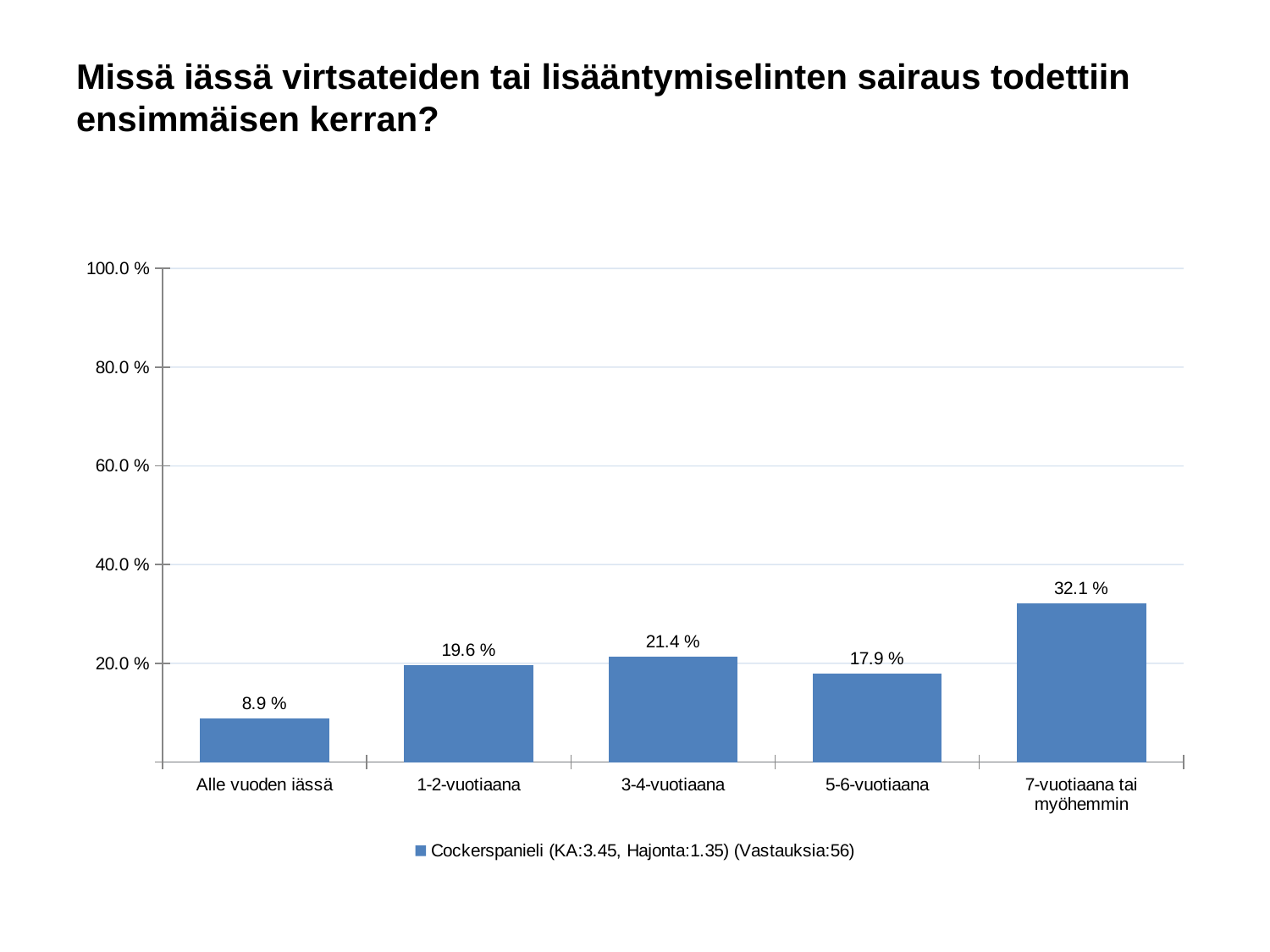
Which category has the highest value? 7-vuotiaana tai myöhemmin Which category has the lowest value? Alle vuoden iässä Which is larger, the value for "1-2-vuotiaana" or the value for "5-6-vuotiaana"? 1-2-vuotiaana What is the value for "3-4-vuotiaana"? 21.4 % What is the value for "Alle vuoden iässä"? 8.9 % What kind of chart is shown on the slide? bar chart How many categories are shown on the x axis? 5 What is the difference between the values for "7-vuotiaana tai myöhemmin" and "Alle vuoden iässä"? 23.2 % What is the legend entry for the series? Cockerspanieli (KA:3.45, Hajonta:1.35) (Vastauksia:56) What is the value for "7-vuotiaana tai myöhemmin"? 32.1 % Is the value for "7-vuotiaana tai myöhemmin" greater or less than 40.0 %? less How many series does the legend list? 1